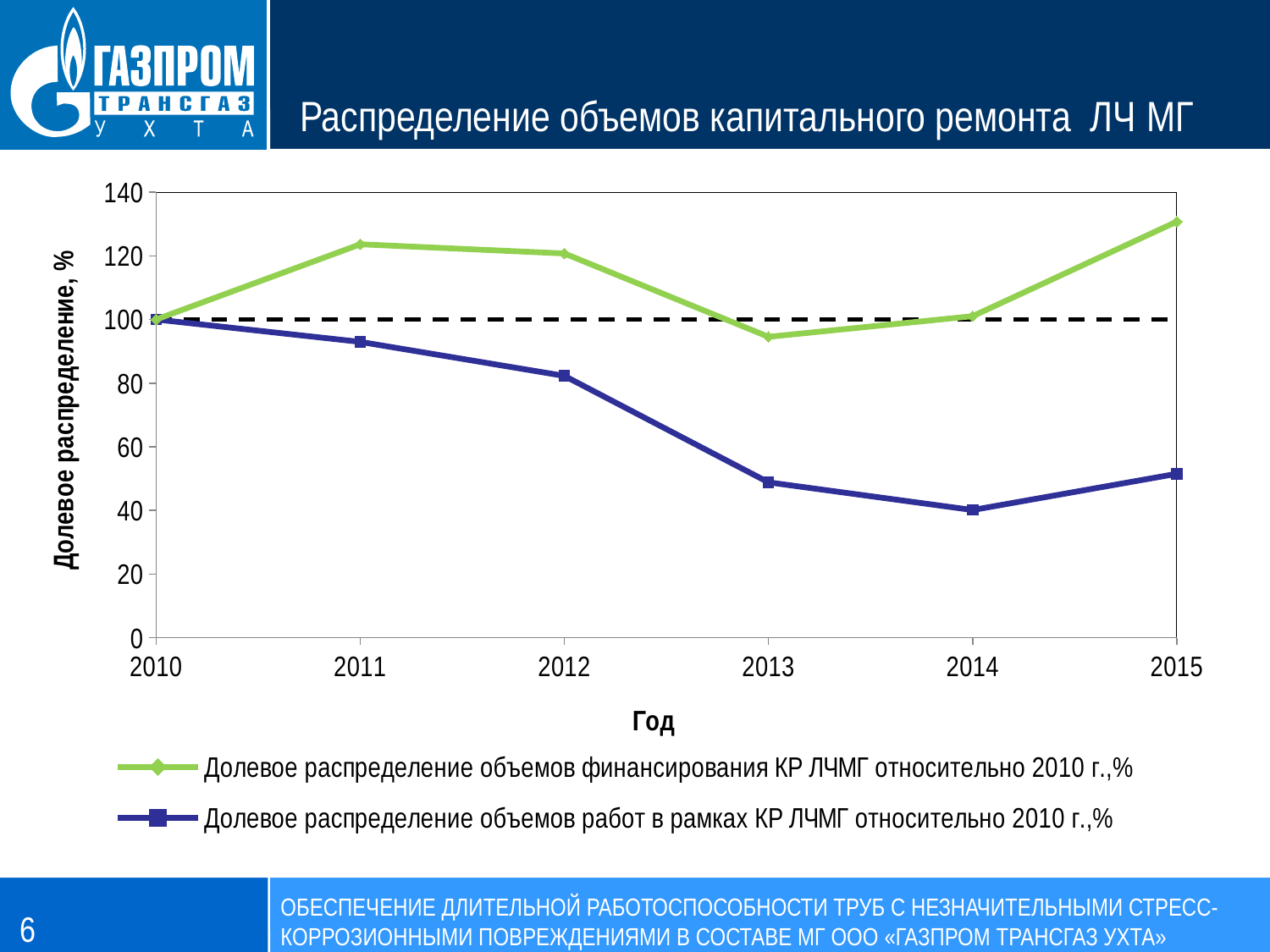
What kind of chart is shown on the slide? line chart How many years are plotted along the x axis? 6 What is the value of the series 'Долевое распределение объемов работ в рамках КР ЛЧМГ относительно 2010 г.,%' in 2010? 100 Is the value for the works series (blue line) in 2014 greater or less than 60? less In 2013, which series has the larger value: the financing series (green line) or the works series (blue line)? the financing series (green line) Is the value for the financing series (green line) in 2015 greater or less than 120? greater Is the value for the financing series (green line) in 2011 greater or less than 120? greater What is the value of the series 'Долевое распределение объемов финансирования КР ЛЧМГ относительно 2010 г.,%' in 2010? 100 How many series does the legend list? 2 Does the works series (blue line) rise or fall from 2010 to 2014? fall In which year does the works series (blue line) reach its lowest value? 2014 In which year does the financing series (green line) reach its highest value? 2015